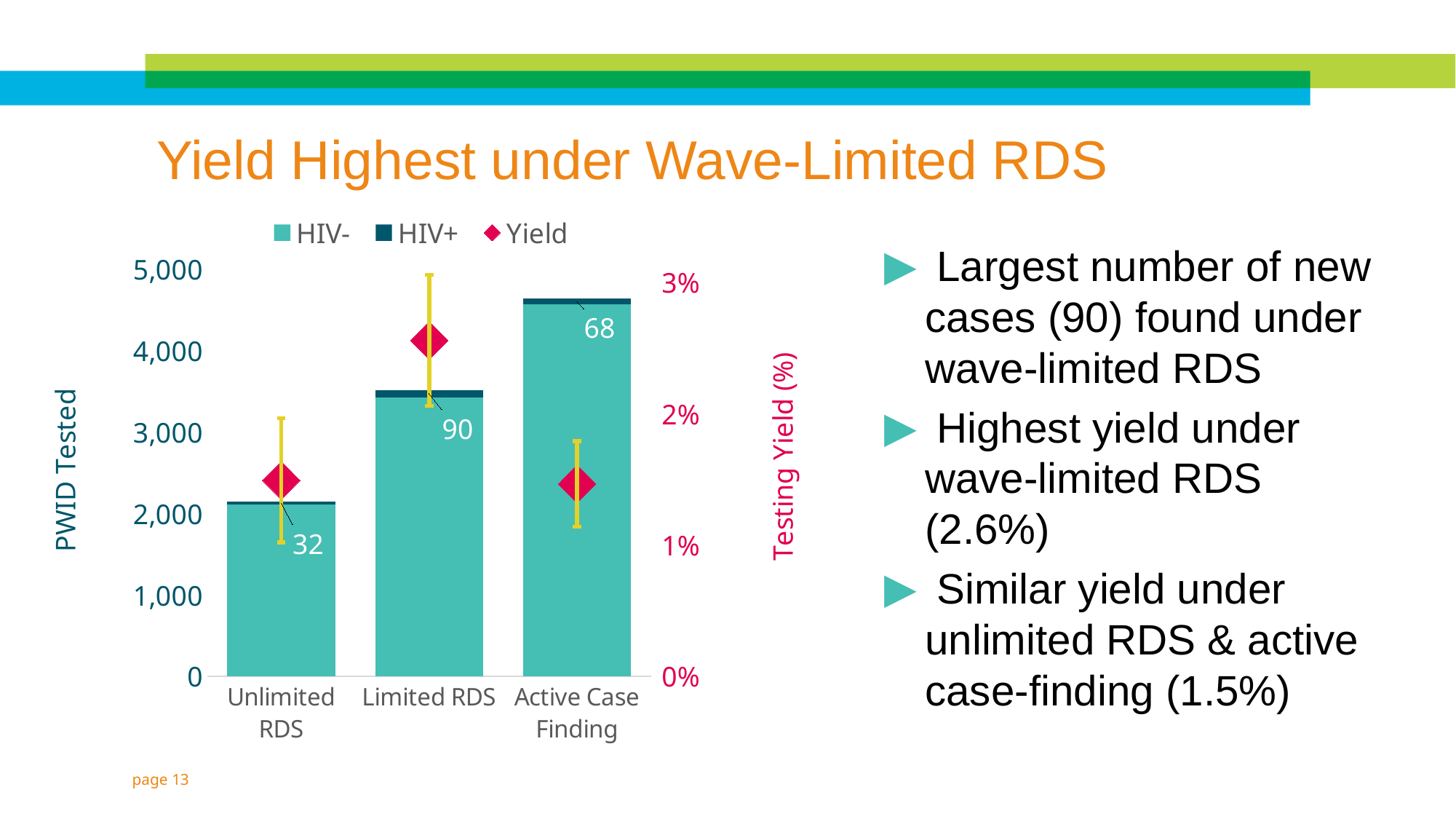
What is the difference between the HIV+ values for Limited RDS and Unlimited RDS? 58 How many series does the legend list? 3 What is the HIV+ value for Unlimited RDS? 32 Which has the larger HIV+ value, Limited RDS or Active Case Finding? Limited RDS Which category has the lowest HIV+ value? Unlimited RDS Is the total PWID tested for Active Case Finding greater or less than 4,000? greater Is the total PWID tested for Unlimited RDS greater or less than 3,000? less What is the HIV+ value for Limited RDS? 90 Which category has the highest HIV+ value? Limited RDS What is the label of the right-hand vertical axis? Testing Yield (%) What is the HIV+ value for Active Case Finding? 68 Which category has the highest Yield marker? Limited RDS